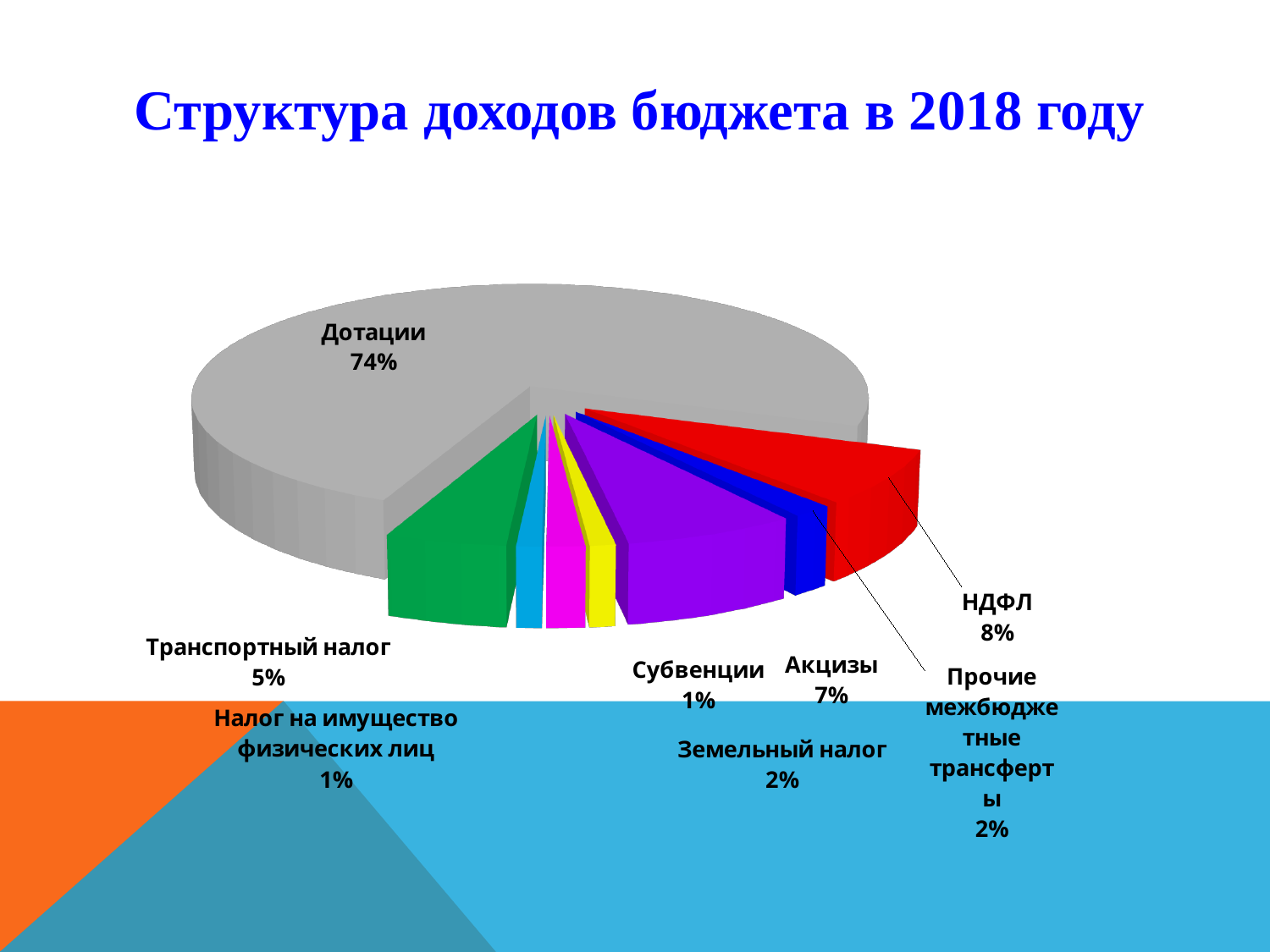
What is the value for НДФЛ? 8% Which is larger, НДФЛ or Акцизы? НДФЛ What is the title of the chart? Структура доходов бюджета в 2018 году What is the value for Акцизы? 7% Which category has the largest share of the pie? Дотации What is the value for Транспортный налог? 5% What is the value for Прочие межбюджетные трансферты? 2% How many categories are shown in the pie chart? 8 What is the difference between the shares of Дотации and НДФЛ? 66% What kind of chart is shown on the slide? pie chart What share of the pie does Дотации have? 74% What is the value for Земельный налог? 2%